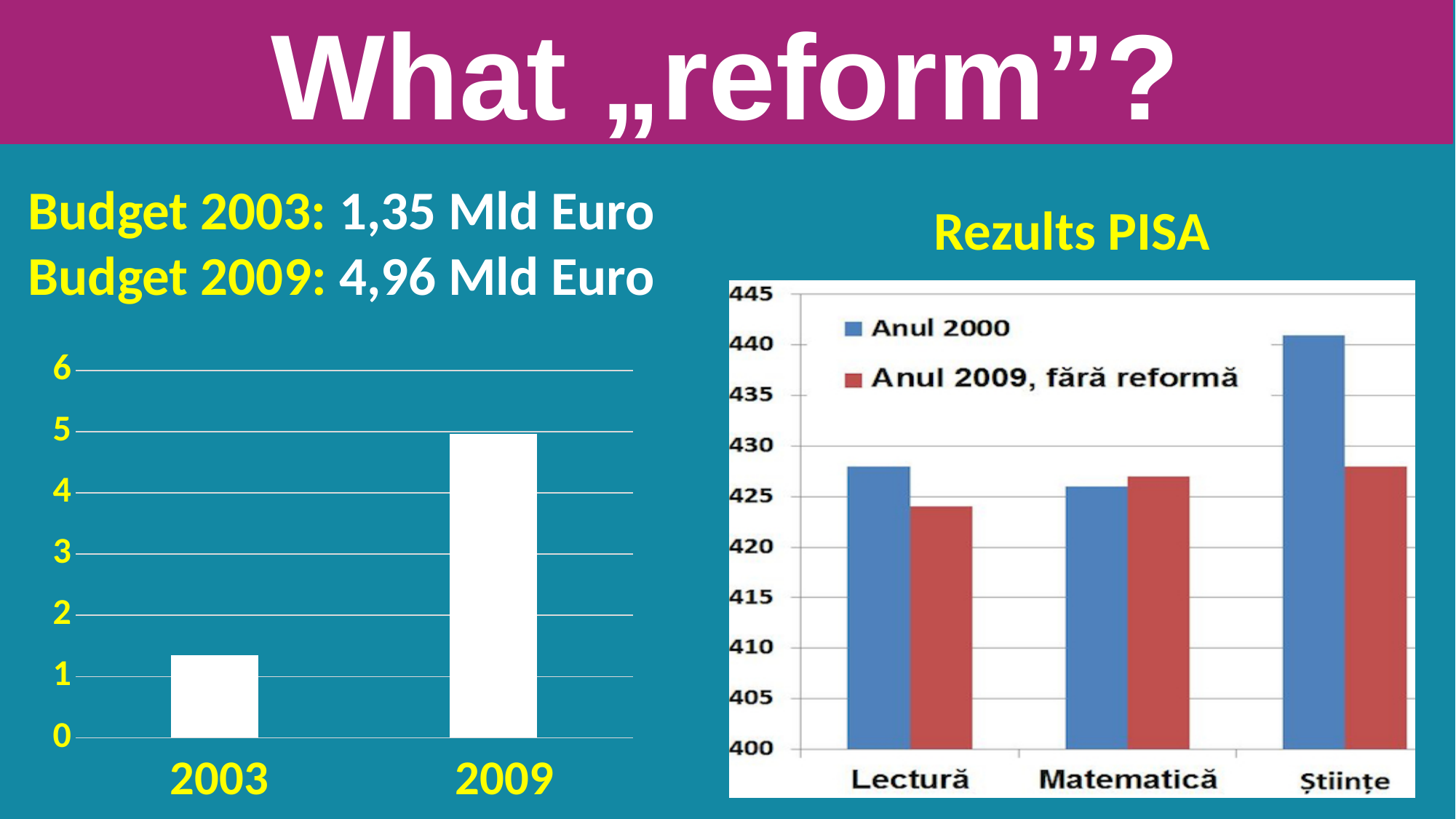
On the 'Rezults PISA' chart, how many categories are shown on the x axis? 3 On the 'Rezults PISA' chart, how many series does the legend list? 2 On the left budget chart, is the value for 2009 greater or less than 4? greater On the left budget chart, how many bars are plotted? 2 On the left budget chart, what is the value for 2003? 1,35 Mld Euro On the 'Rezults PISA' chart, which category has the highest value for Anul 2000? Științe On the 'Rezults PISA' chart, what colour are the bars for Anul 2009, fără reformă? red What kind of chart is the left budget chart? bar chart On the left budget chart, what is the value for 2009? 4,96 Mld Euro On the left budget chart, which year has the higher bar? 2009 On the 'Rezults PISA' chart, for Științe, which series has the larger value: Anul 2000 or Anul 2009, fără reformă? Anul 2000 On the 'Rezults PISA' chart, is the Anul 2000 value for Științe greater or less than 435? greater